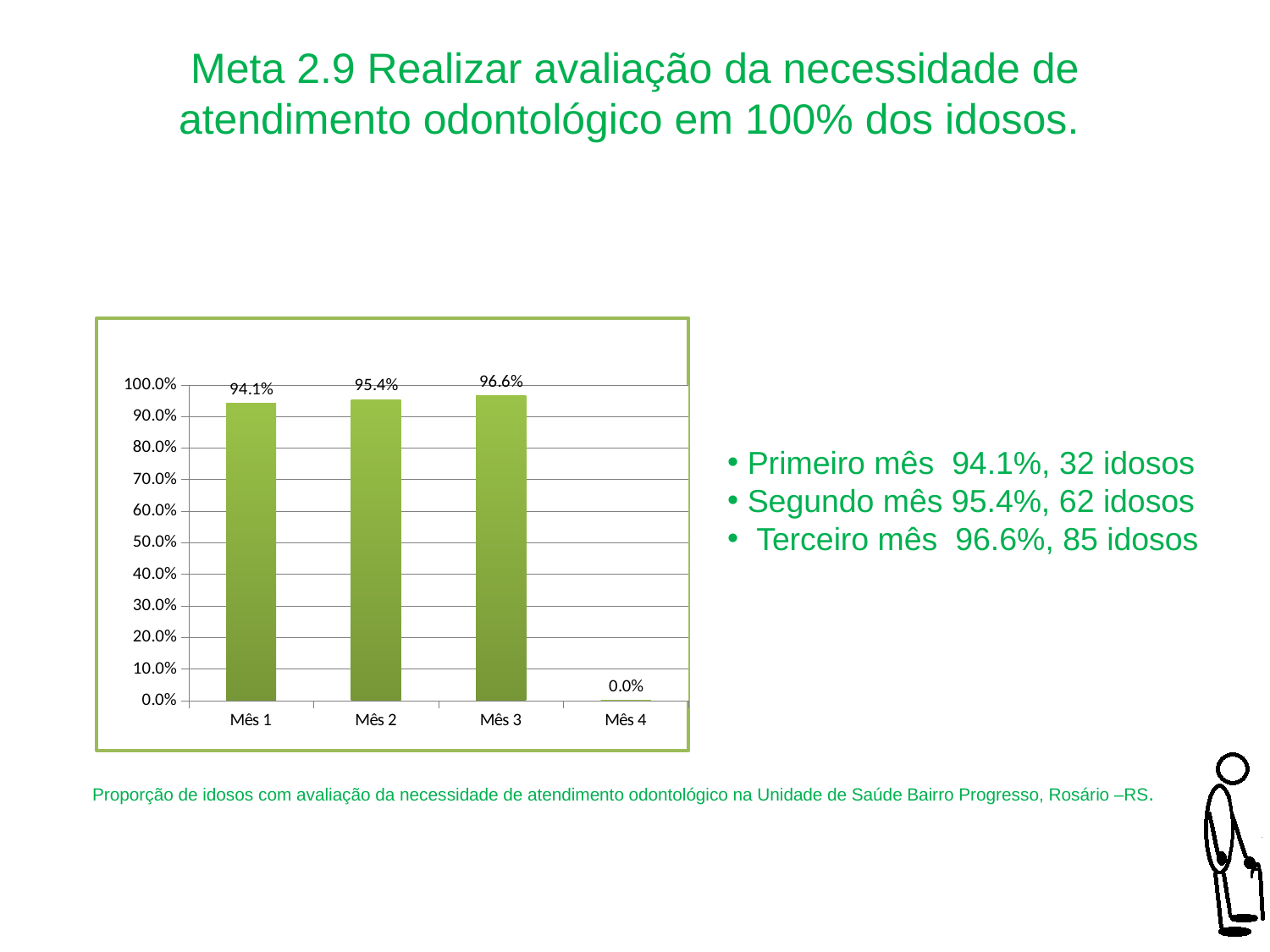
What is the difference between the values for Mês 3 and Mês 1? 2.5% Which category has the lowest value? Mês 4 Which is larger, the value for Mês 2 or the value for Mês 1? Mês 2 Which category has the highest value? Mês 3 Do the values rise or fall from Mês 1 to Mês 3? rise What is the value for Mês 1? 94.1% What is the value for Mês 2? 95.4% What is the value for Mês 4? 0.0% What is the value for Mês 3? 96.6% Is the value for Mês 2 greater or less than 90.0%? greater What kind of chart is shown on the slide? bar chart How many categories are shown on the x axis? 4